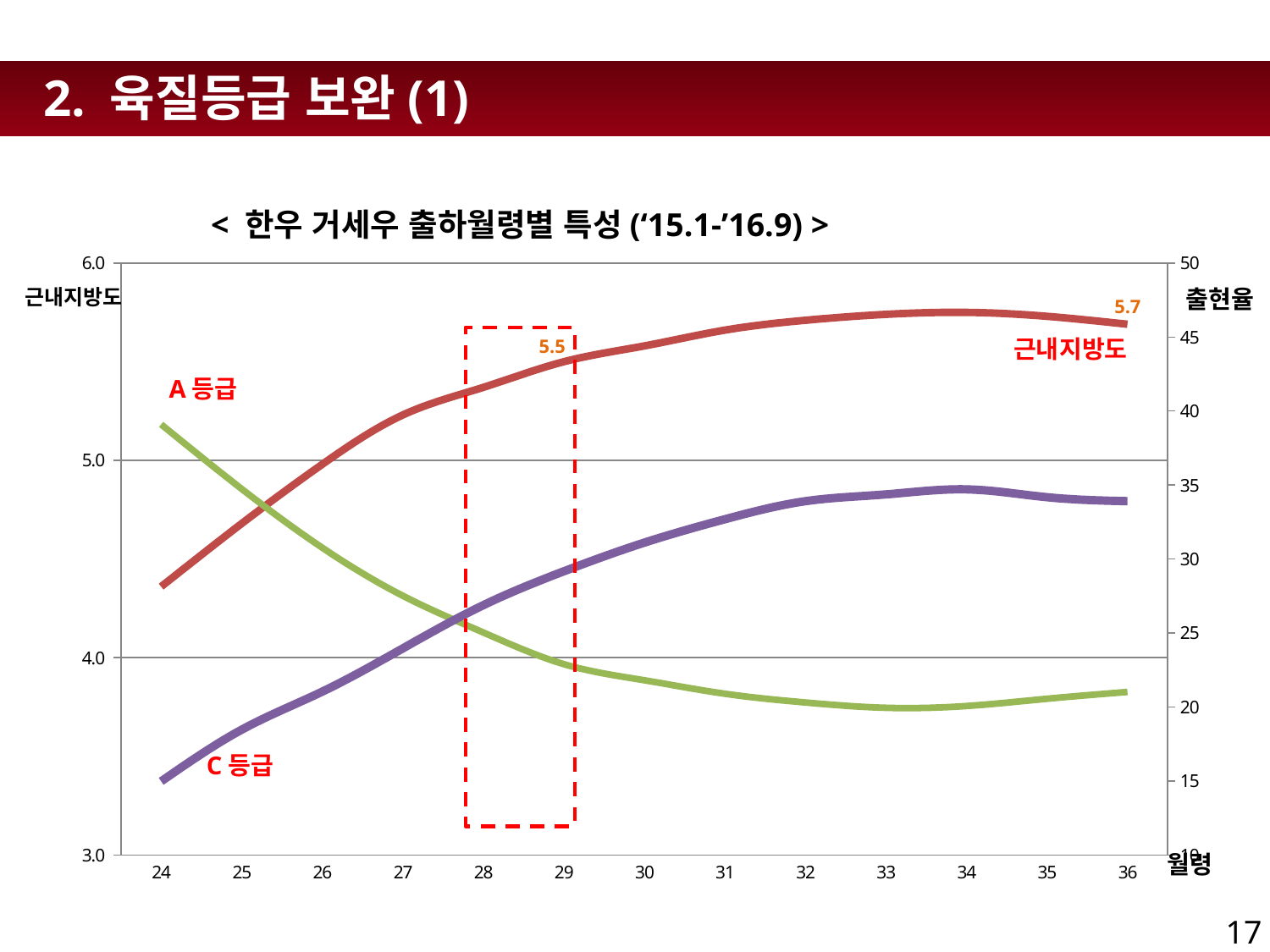
Is the C 등급 value at 24 months greater or less than 20 on the 출현율 axis? less What is the 근내지방도 value labelled at 29 months (월령 29)? 5.5 How many 월령 (month) categories are shown on the x axis? 13 What kind of chart is shown on the slide? line chart At 24 months, which is higher: A 등급 or C 등급? A 등급 Does the C 등급 line rise or fall as 월령 increases from 24 to 34? rise What is the 근내지방도 value at 36 months (월령 36)? 5.7 Does the A 등급 line rise or fall as 월령 increases from 24 to 33? fall What is the title of the chart? 한우 거세우 출하월령별 특성 ('15.1-'16.9) At 36 months, which is higher: A 등급 or C 등급? C 등급 Is the A 등급 value at 24 months greater or less than 35 on the 출현율 axis? greater What is the difference between the 근내지방도 values labelled at 36 months and 29 months? 0.2